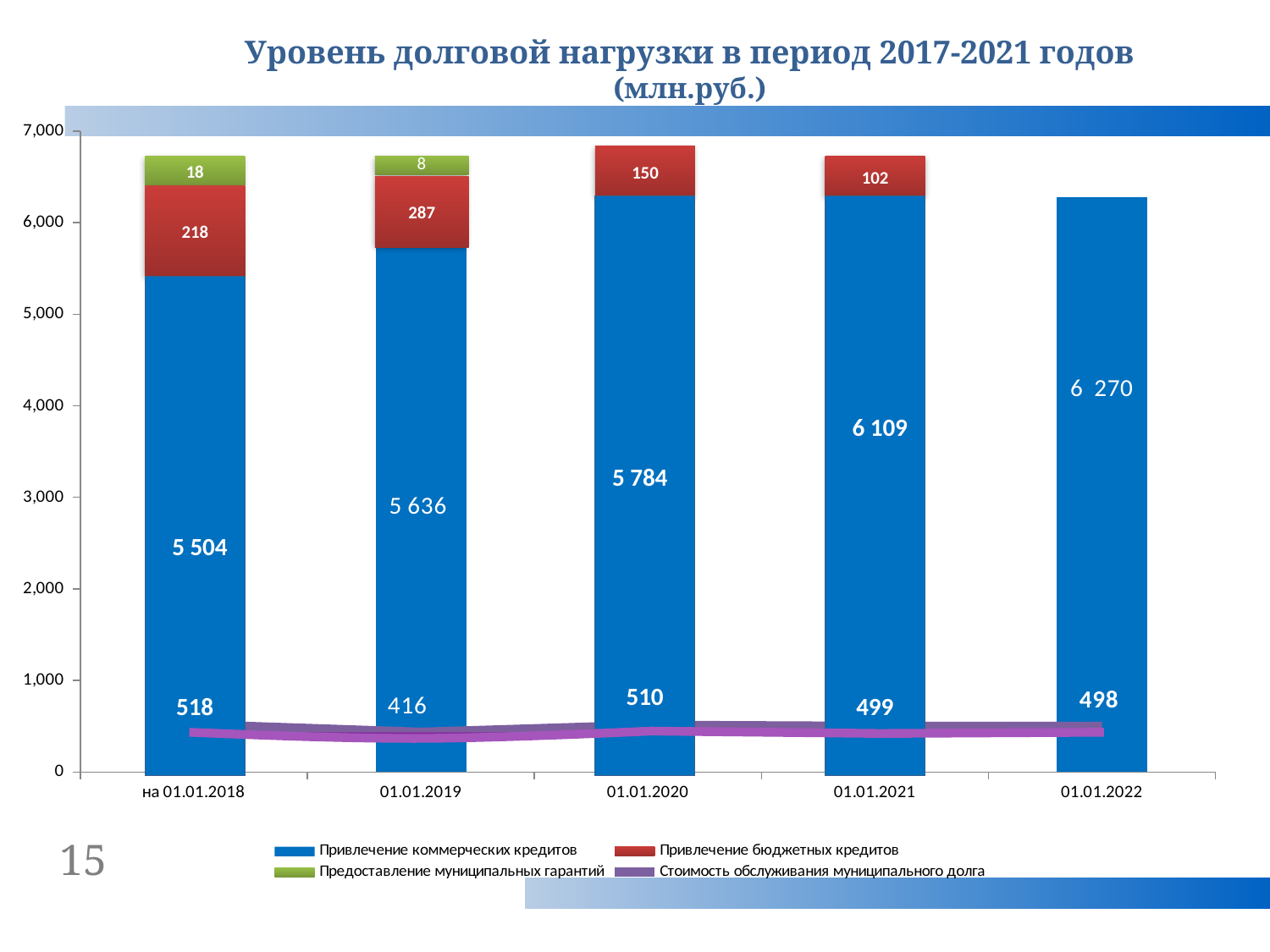
In which period is Стоимость обслуживания муниципального долга the lowest? 01.01.2019 What is the value of Предоставление муниципальных гарантий for на 01.01.2018? 18 What is the total of the stacked bar for 01.01.2021 (Привлечение коммерческих кредитов plus Привлечение бюджетных кредитов)? 6 211 How many series does the legend list? 4 What is the value of Привлечение бюджетных кредитов for 01.01.2019? 287 What is the value of Привлечение коммерческих кредитов for 01.01.2020? 5 784 In which period is Привлечение коммерческих кредитов the highest? 01.01.2022 What is the difference between Привлечение коммерческих кредитов for 01.01.2022 and for на 01.01.2018? 766 Does Привлечение коммерческих кредитов rise or fall from на 01.01.2018 to 01.01.2022? rise Which is larger for Привлечение бюджетных кредитов: на 01.01.2018 or 01.01.2020? на 01.01.2018 How many periods are shown on the x axis? 5 What is the value of Стоимость обслуживания муниципального долга for 01.01.2021? 499